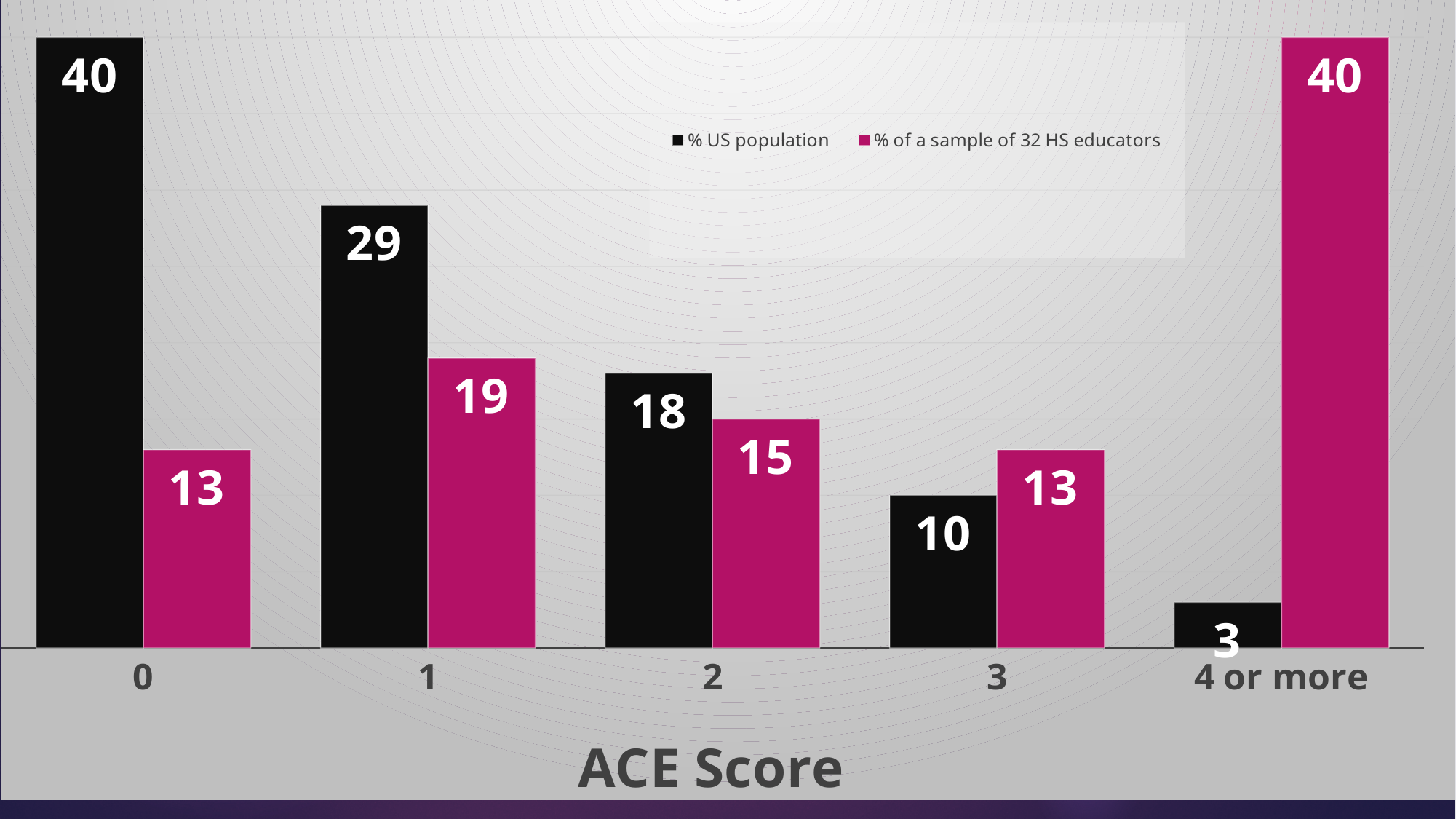
Which ACE Score category has the lowest % US population value? 4 or more What is the value for the sample of 32 HS educators at an ACE Score of 1? 19 What is the difference between the % US population and the HS educators sample at an ACE Score of 0? 27 How many ACE Score categories are shown on the x axis? 5 At an ACE Score of 3, which series has the larger value? % of a sample of 32 HS educators How many series does the legend list? 2 Which ACE Score category has the highest value for the sample of 32 HS educators? 4 or more What is the % US population value for an ACE Score of 0? 40 What is the value for the sample of 32 HS educators at an ACE Score of 4 or more? 40 Do the % US population values rise or fall as the ACE Score increases from 0 to 4 or more? Fall What kind of chart is shown on the slide? Bar chart What is the % US population value for an ACE Score of 2? 18